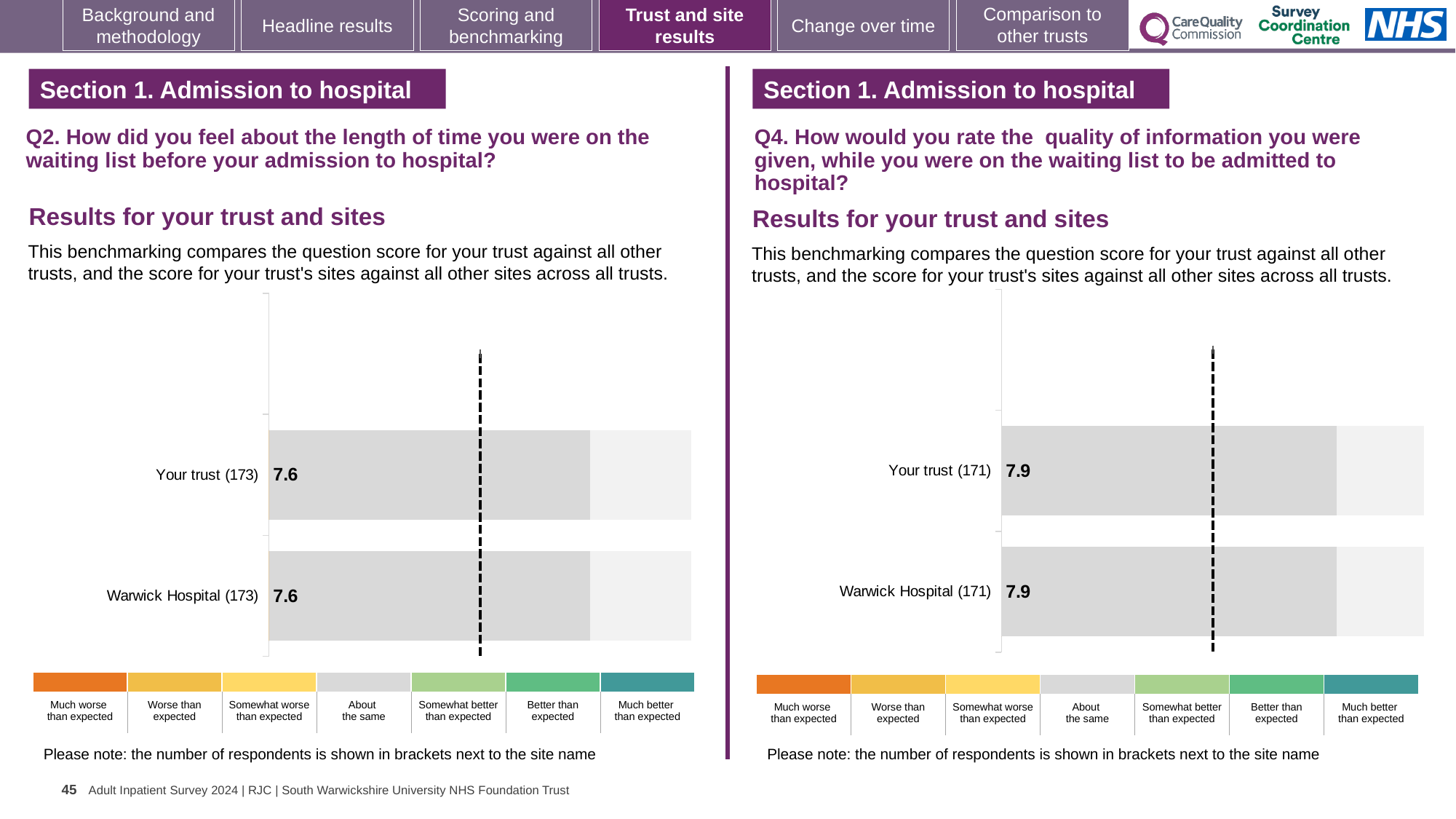
In the left chart (Q2), how many respondents are shown in brackets next to Warwick Hospital? 173 In the left chart (Q2), what is the difference between the score for Your trust and the score for Warwick Hospital? 0 In the left chart (Q2, length of time on the waiting list), what is the score for Warwick Hospital? 7.6 Is the score for Your trust in the right chart (Q4) larger or smaller than the score for Your trust in the left chart (Q2)? Larger How many bars are plotted in the right chart (Q4)? 2 What kind of chart is used in the left chart (Q2)? Bar chart In the right chart (Q4), what is the difference between the score for Your trust and the score for Warwick Hospital? 0 In the left chart (Q2, length of time on the waiting list), what is the score for Your trust? 7.6 In the right chart (Q4), how many respondents are shown in brackets next to Your trust? 171 In the right chart (Q4, quality of information while on the waiting list), what is the score for Warwick Hospital? 7.9 In the right chart (Q4, quality of information while on the waiting list), what is the score for Your trust? 7.9 How many bars are plotted in the left chart (Q2)? 2